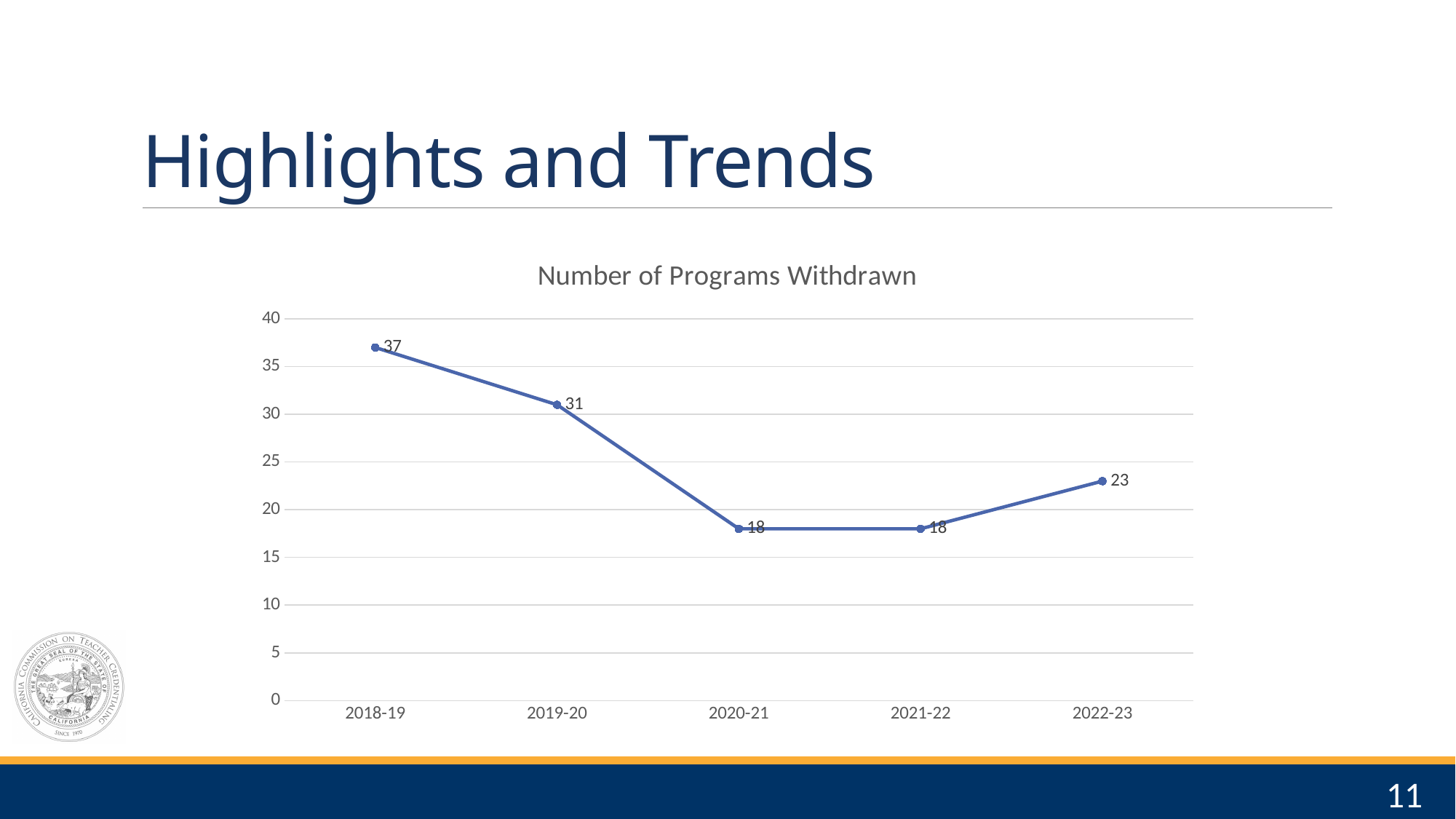
Is the value for 2020-21 greater or less than 20? less How many years are plotted on the chart? 5 What is the lowest value shown on the chart? 18 What is the difference between the number of programs withdrawn in 2018-19 and 2019-20? 6 How many more programs were withdrawn in 2022-23 than in 2021-22? 5 What is the title of the chart? Number of Programs Withdrawn What is the number of programs withdrawn in 2018-19? 37 What is the number of programs withdrawn in 2022-23? 23 What kind of chart is shown on the slide? line chart Which year has the highest number of programs withdrawn? 2018-19 What is the number of programs withdrawn in 2019-20? 31 Which is larger, the value for 2019-20 or the value for 2022-23? 2019-20